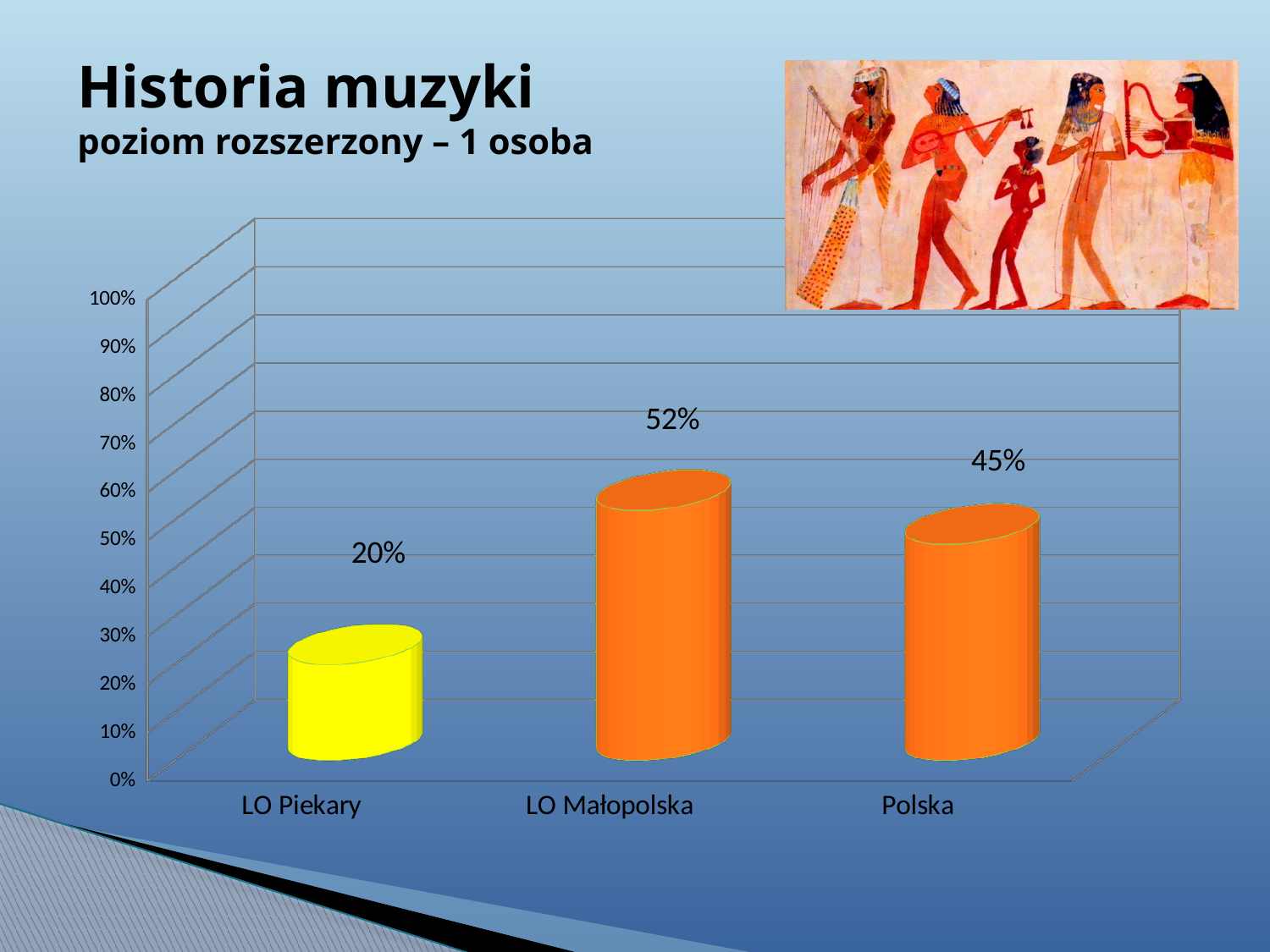
Which is larger, the value for Polska or the value for LO Piekary? Polska What is the difference between the values for LO Małopolska and LO Piekary? 32% How many categories are shown on the chart? 3 Which category has the highest value? LO Małopolska What is the value for LO Piekary? 20% Which category has the lowest value? LO Piekary Is the value for Polska greater or less than 40%? greater What is the value for LO Małopolska? 52% What is the value for Polska? 45% What is the difference between the values for LO Małopolska and Polska? 7% What kind of chart is shown on the slide? bar chart Which category's bar is coloured yellow? LO Piekary